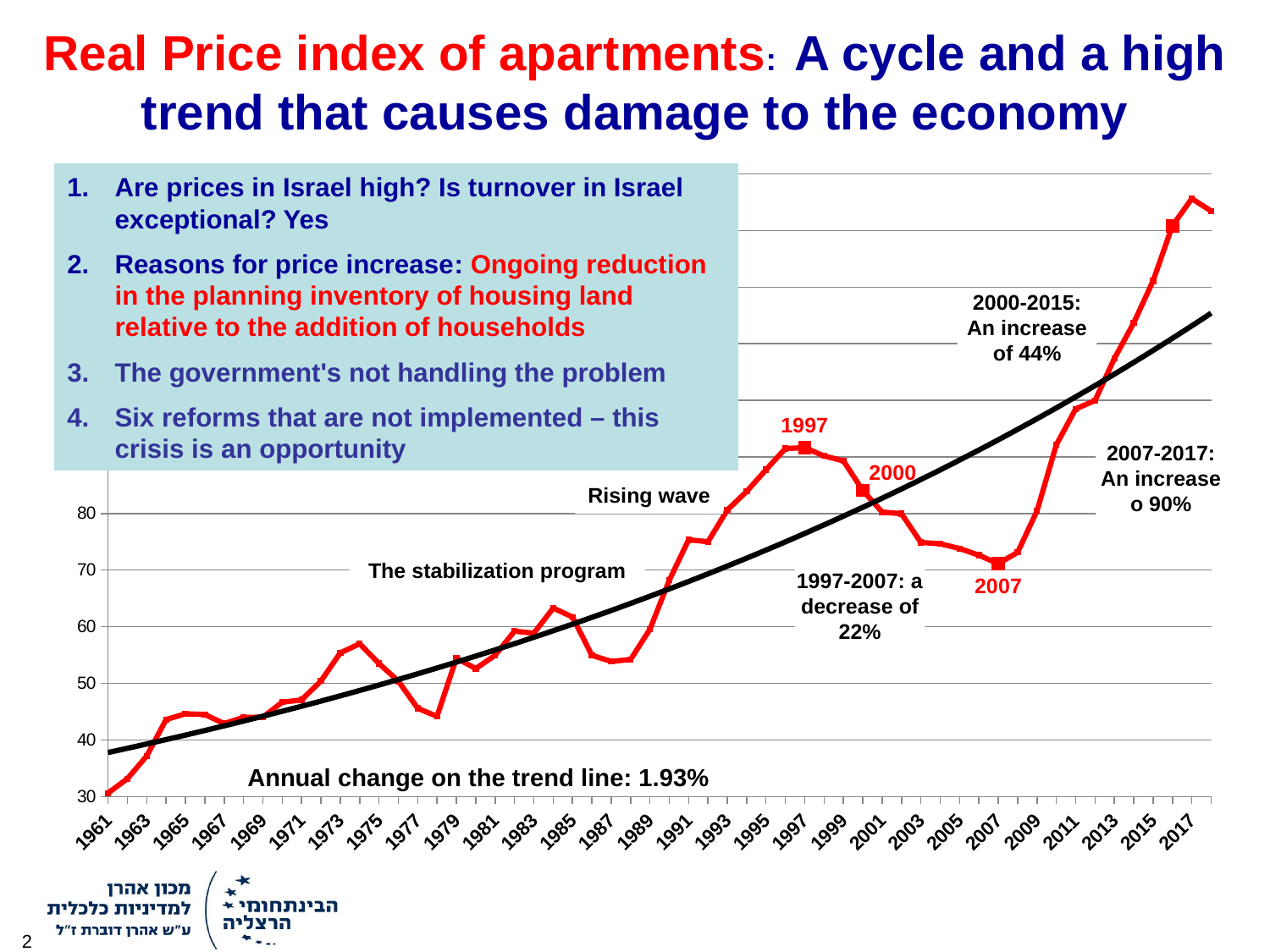
What kind of chart is shown on the slide? line chart Which year has the higher real price index, 1997 or 2007? 1997 Is the value for 1985 greater or less than 60? greater Overall, does the real price index of apartments rise or fall from 1961 to 2017? rise Which year has the lowest value of the real price index on the chart? 1961 Is the value for 1997 greater or less than 80? greater Which year has the higher real price index, 1974 or 1978? 1974 Is the value for 1978 greater or less than 50? less According to the annotation on the chart, what is the annual change on the trend line? 1.93% According to the annotation on the chart, by how much did the index decrease between 1997 and 2007? 22%